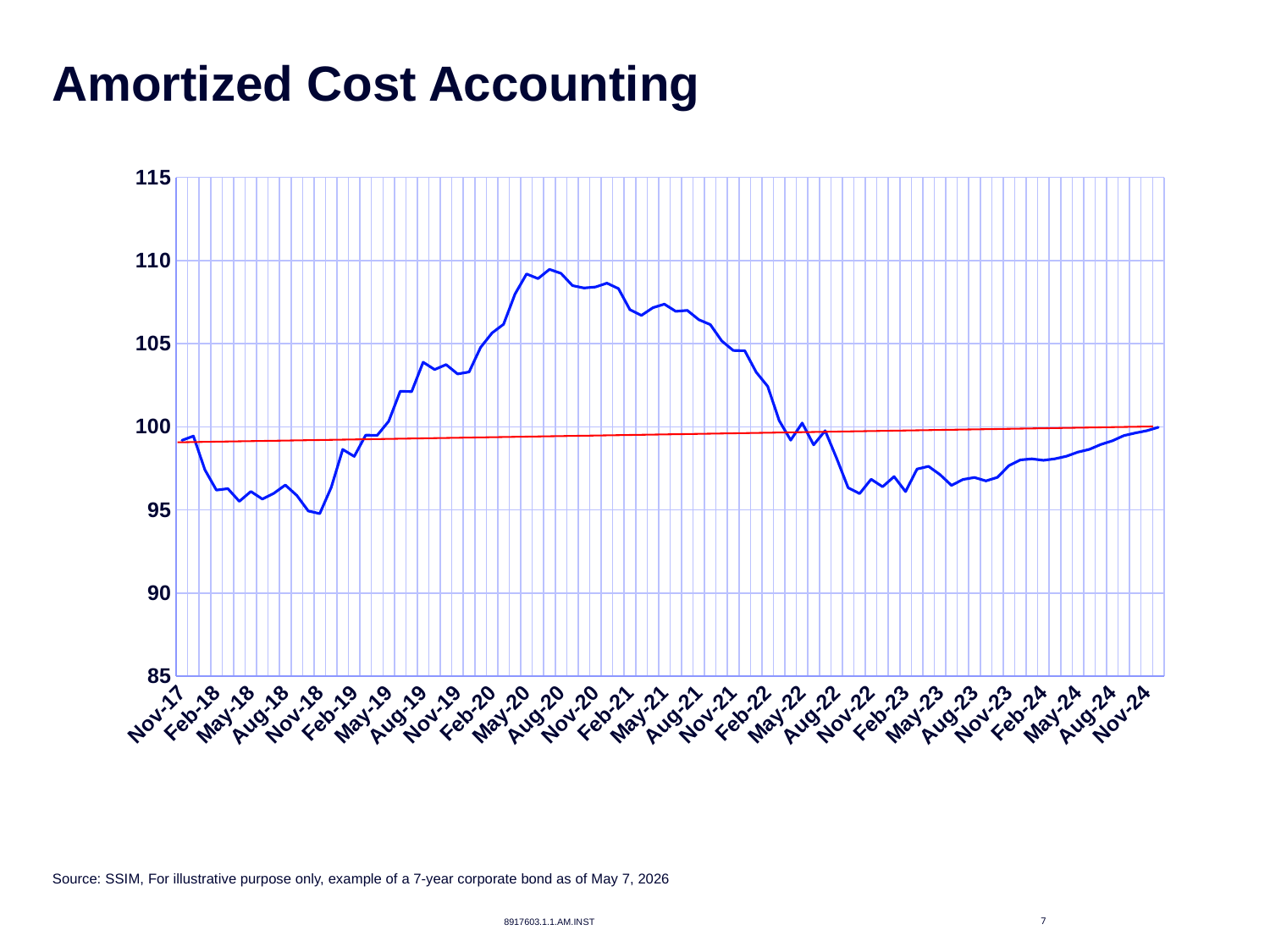
Is the value of the blue line at Feb-21 greater or less than 105? greater Is the value of the blue line at Nov-22 greater or less than 100? less How many lines are plotted on the chart? 2 What is the title of the slide containing the chart? Amortized Cost Accounting What kind of chart is shown on the slide? line chart Does the blue line rise or fall between Aug-20 and Nov-22? fall Around which x-axis label does the blue line reach its highest point? Aug-20 Is the value of the blue line at Nov-18 greater or less than 100? less What are the lowest and highest values shown on the y axis? 85 and 115 Which is larger, the blue line's value at Aug-20 or at Nov-18? Aug-20 How many date labels are shown on the x axis? 29